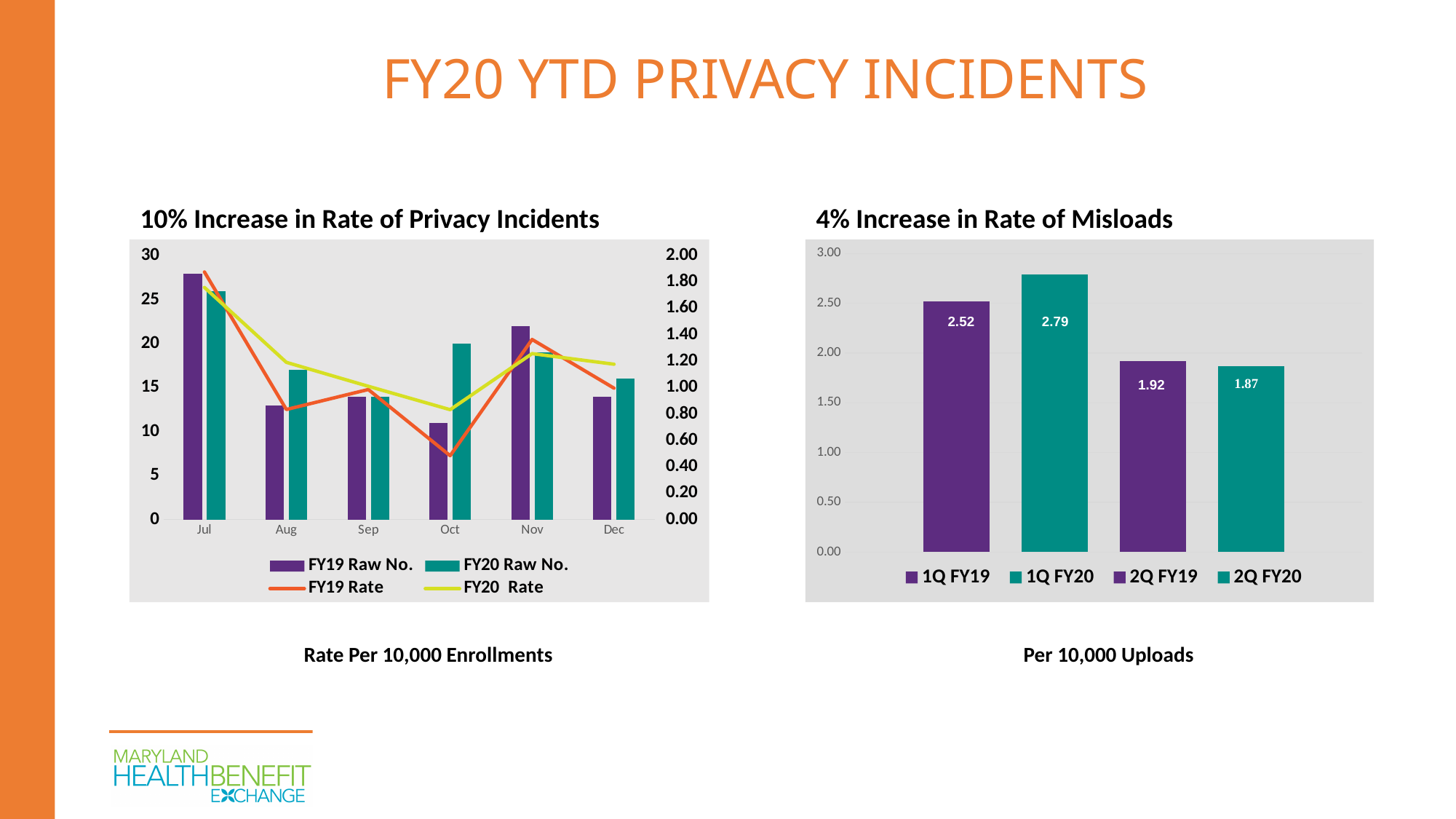
In the '4% Increase in Rate of Misloads' chart, what is the value for 2Q FY19? 1.92 In the '4% Increase in Rate of Misloads' chart, which category has the lowest value? 2Q FY20 In the '4% Increase in Rate of Misloads' chart, what is the value for 1Q FY20? 2.79 In the '10% Increase in Rate of Privacy Incidents' chart, how many series does the legend list? 4 In the '10% Increase in Rate of Privacy Incidents' chart, is the FY19 Raw No. value for Jul greater or less than 25? greater In the '4% Increase in Rate of Misloads' chart, how many bars are plotted? 4 What kind of chart is the '4% Increase in Rate of Misloads' chart? Bar chart In the '10% Increase in Rate of Privacy Incidents' chart, which is larger in Oct, the FY19 Raw No. bar or the FY20 Raw No. bar? FY20 Raw No. In the '4% Increase in Rate of Misloads' chart, what is the difference between the 1Q FY20 and 1Q FY19 values? 0.27 In the '4% Increase in Rate of Misloads' chart, which category has the highest value? 1Q FY20 What unit is stated below the '4% Increase in Rate of Misloads' chart? Per 10,000 Uploads In the '10% Increase in Rate of Privacy Incidents' chart, in which month is the FY19 Raw No. bar highest? Jul